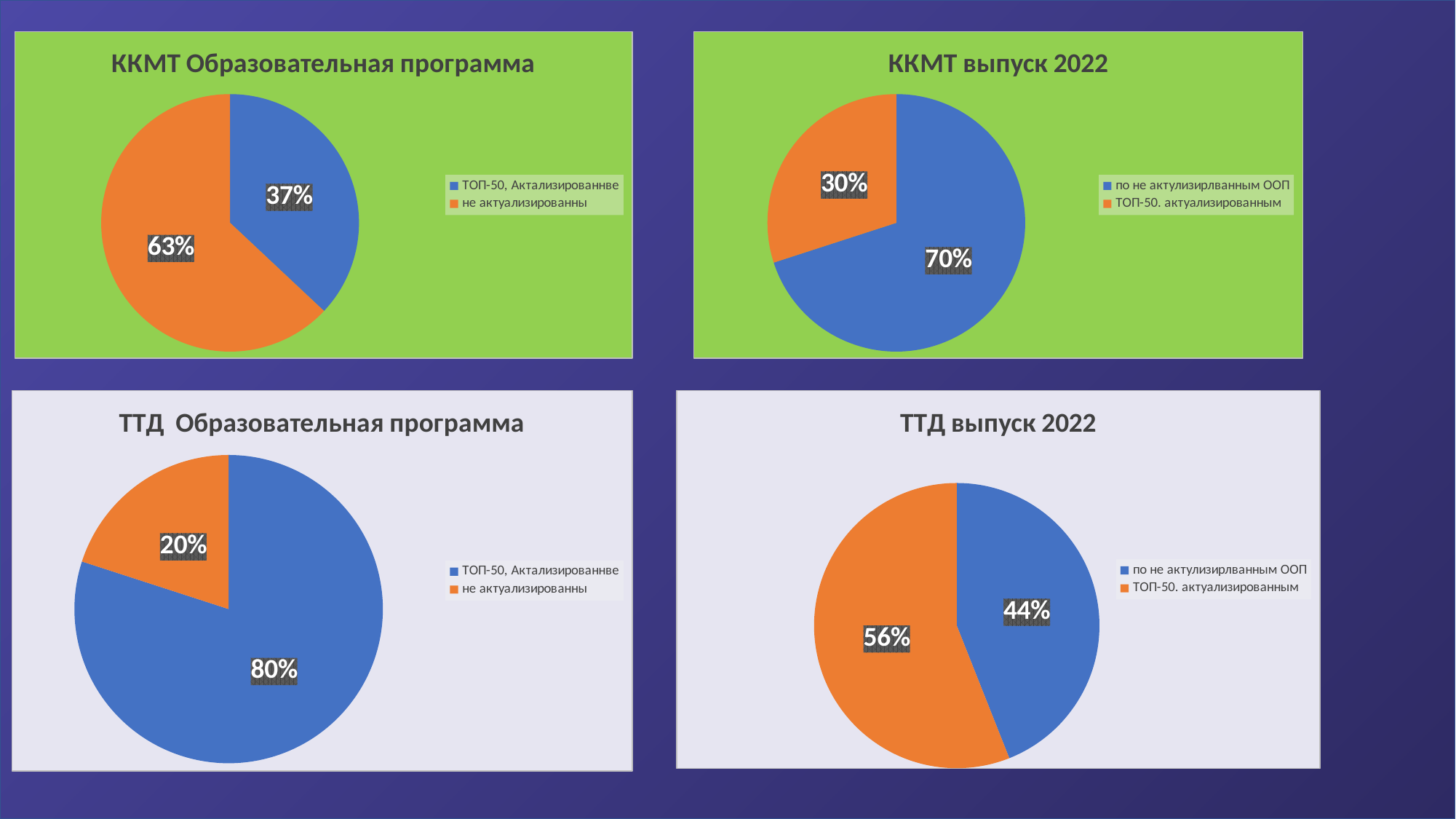
In the chart titled "ТТД выпуск 2022", what is the value for "ТОП-50. актуализированным"? 56% In the chart titled "ККМТ выпуск 2022", what is the value for "по не актулизирлванным ООП"? 70% In the chart titled "ККМТ Образовательная программа", what share does the "не актуализированны" slice have? 63% What type of chart is "ТТД выпуск 2022"? Pie chart How many series does the legend of the chart titled "ТТД Образовательная программа" list? 2 In the chart titled "ТТД выпуск 2022", which slice is larger: "по не актулизирлванным ООП" or "ТОП-50. актуализированным"? ТОП-50. актуализированным In the chart titled "ТТД Образовательная программа", what is the difference between the two slices? 60% In the chart titled "ККМТ выпуск 2022", which slice is the largest? по не актулизирлванным ООП In the chart titled "ТТД Образовательная программа", what is the value for "ТОП-50, Актализированнве"? 80% In the chart titled "ККМТ Образовательная программа", what is the difference between the "не актуализированны" and "ТОП-50, Актализированнве" slices? 26% In the chart titled "ККМТ Образовательная программа", what share does the "ТОП-50, Актализированнве" slice have? 37% In the chart titled "ККМТ выпуск 2022", what is the value for "ТОП-50. актуализированным"? 30%